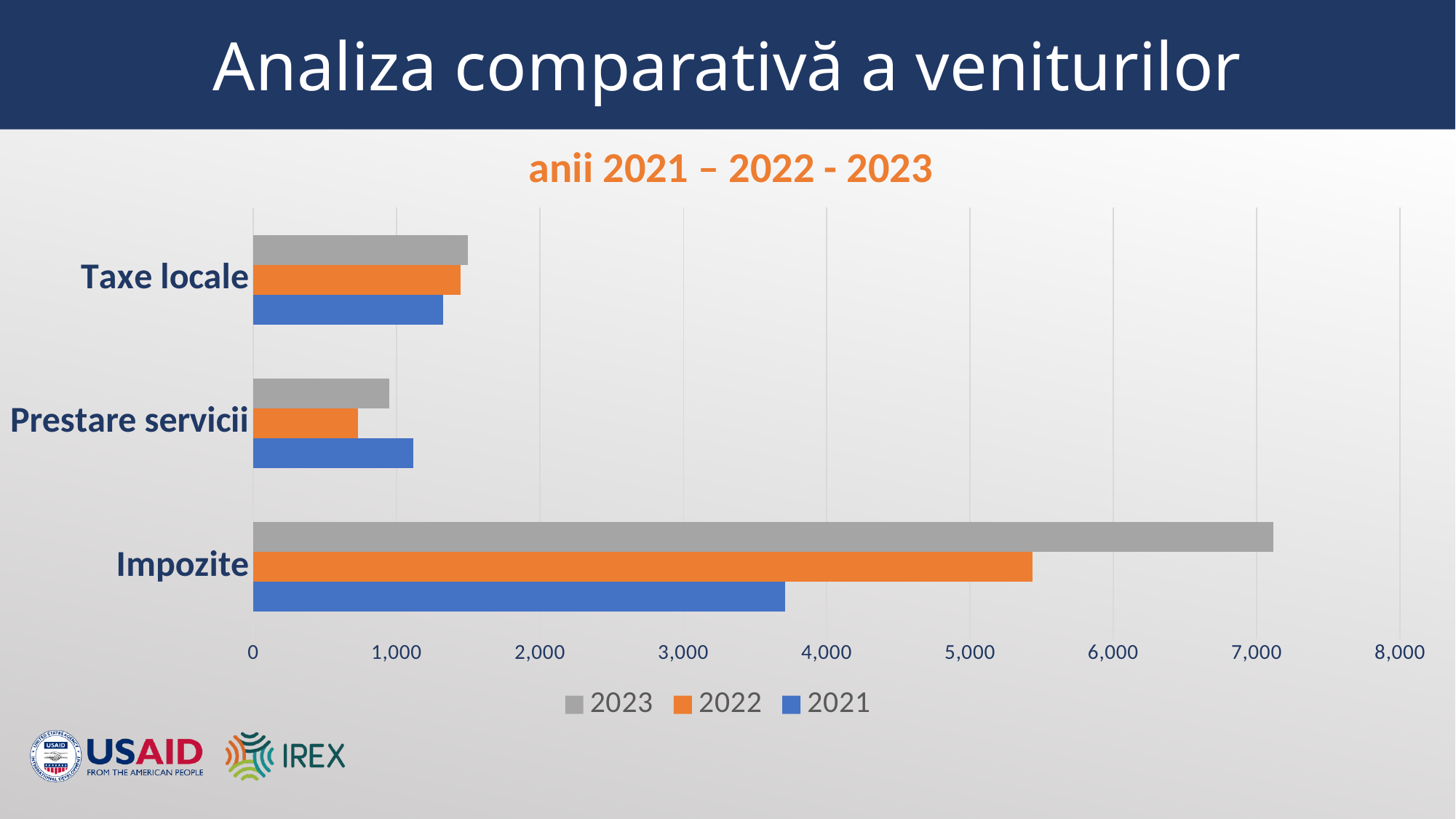
Is the value for Prestare servicii in 2022 greater or less than 1,000? less How many categories are shown on the chart? 3 Is the value for Impozite in 2021 greater or less than 4,000? less Which category has the highest value for 2023? Impozite What kind of chart is shown on the slide? bar chart For Prestare servicii, which year has the larger value, 2021 or 2022? 2021 For Impozite, which year has the larger value, 2022 or 2023? 2023 How many series does the legend list? 3 Which colour represents the 2022 series in the legend? orange Is the value for Impozite in 2023 greater or less than 7,000? greater Which category has the lowest value for 2022? Prestare servicii